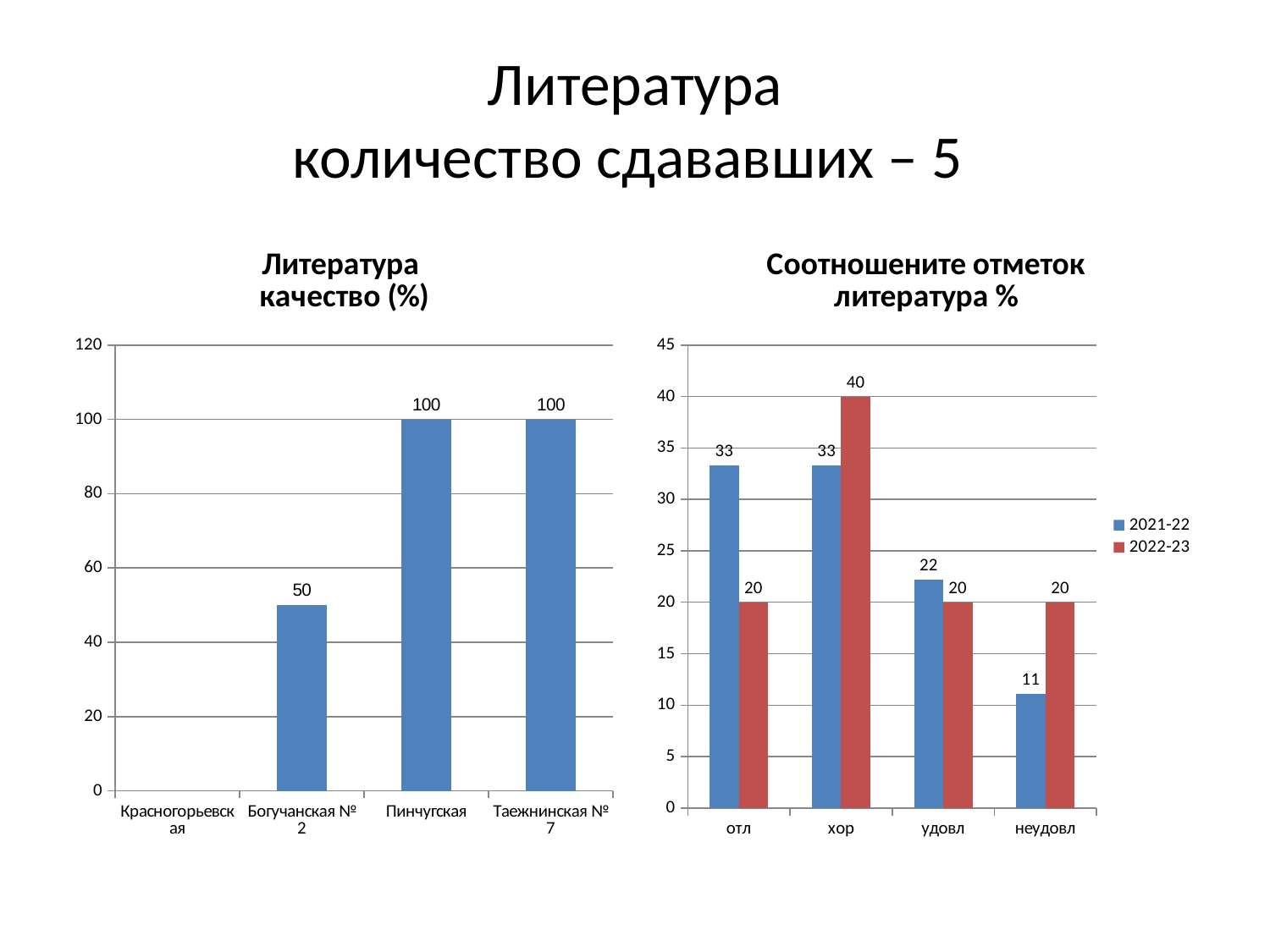
In the chart titled 'Соотношените отметок литература %', which category has the highest value for the 2022-23 series? хор In the chart titled 'Литература качество (%)', what is the value for Богучанская № 2? 50 In the chart titled 'Литература качество (%)', which category has the lowest value among those with a labelled bar? Богучанская № 2 In the chart titled 'Соотношените отметок литература %', what is the value for хор in 2022-23? 40 In the chart titled 'Соотношените отметок литература %', how many series does the legend list? 2 In the chart titled 'Литература качество (%)', how many categories are shown on the x axis? 4 In the chart titled 'Соотношените отметок литература %', what is the value for неудовл in 2021-22? 11 What kind of chart is the chart titled 'Соотношените отметок литература %'? Bar chart In the chart titled 'Литература качество (%)', what is the value for Пинчугская? 100 In the chart titled 'Соотношените отметок литература %', which is larger for отл: the 2021-22 value or the 2022-23 value? 2021-22 In the chart titled 'Соотношените отметок литература %', what is the difference between the 2021-22 and 2022-23 values for удовл? 2 In the chart titled 'Литература качество (%)', what is the difference between the values for Таежнинская № 7 and Богучанская № 2? 50